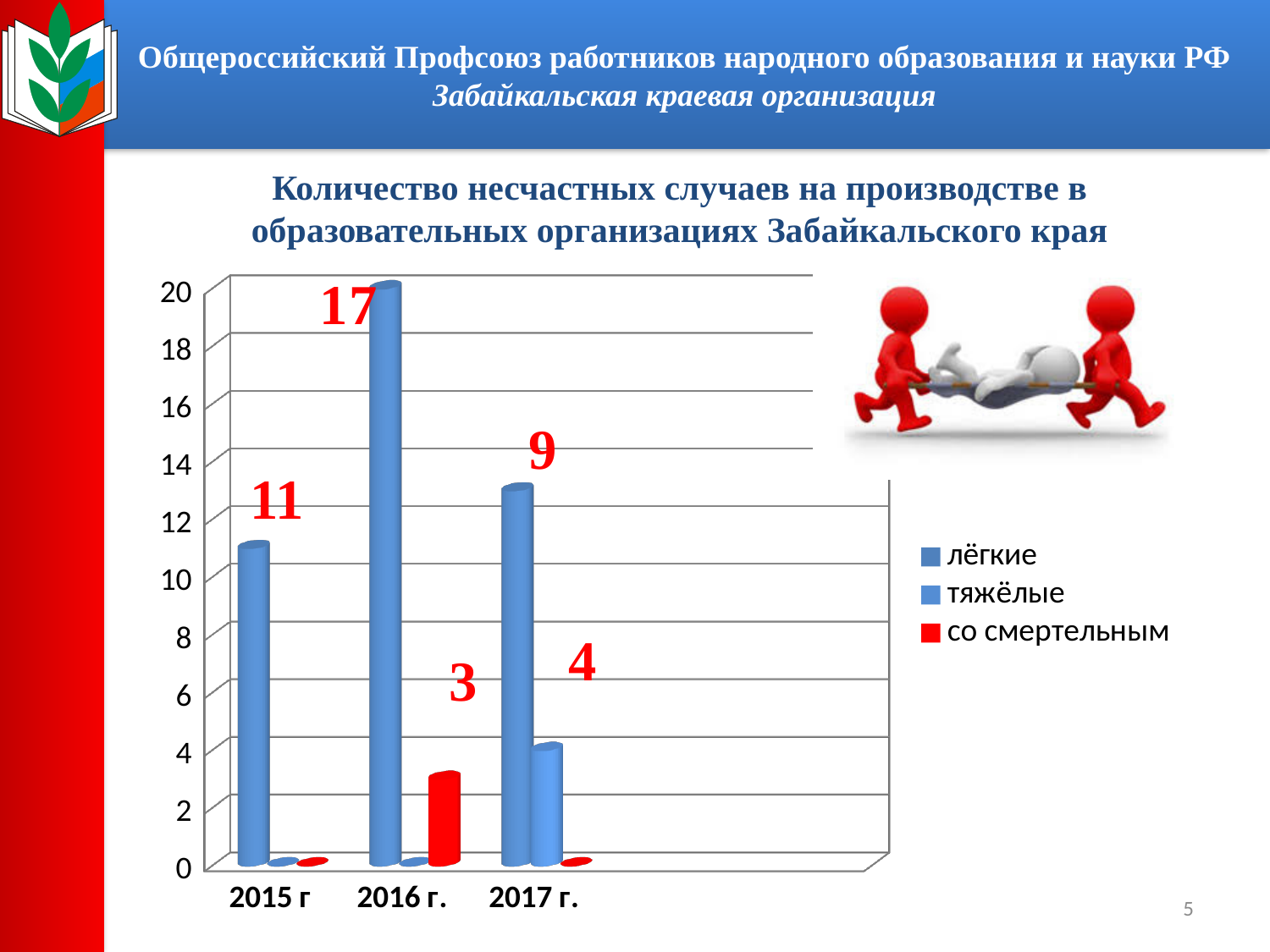
What is the value for со смертельным in 2016 г.? 3 What is the value for лёгкие in 2015 г? 11 How many series does the legend list? 3 Which is larger in 2017 г.: лёгкие or тяжёлые? лёгкие What is the value for тяжёлые in 2017 г.? 4 How many years are shown on the x axis? 3 In which year is the value for лёгкие highest? 2016 г. What kind of chart is shown on the slide? bar chart